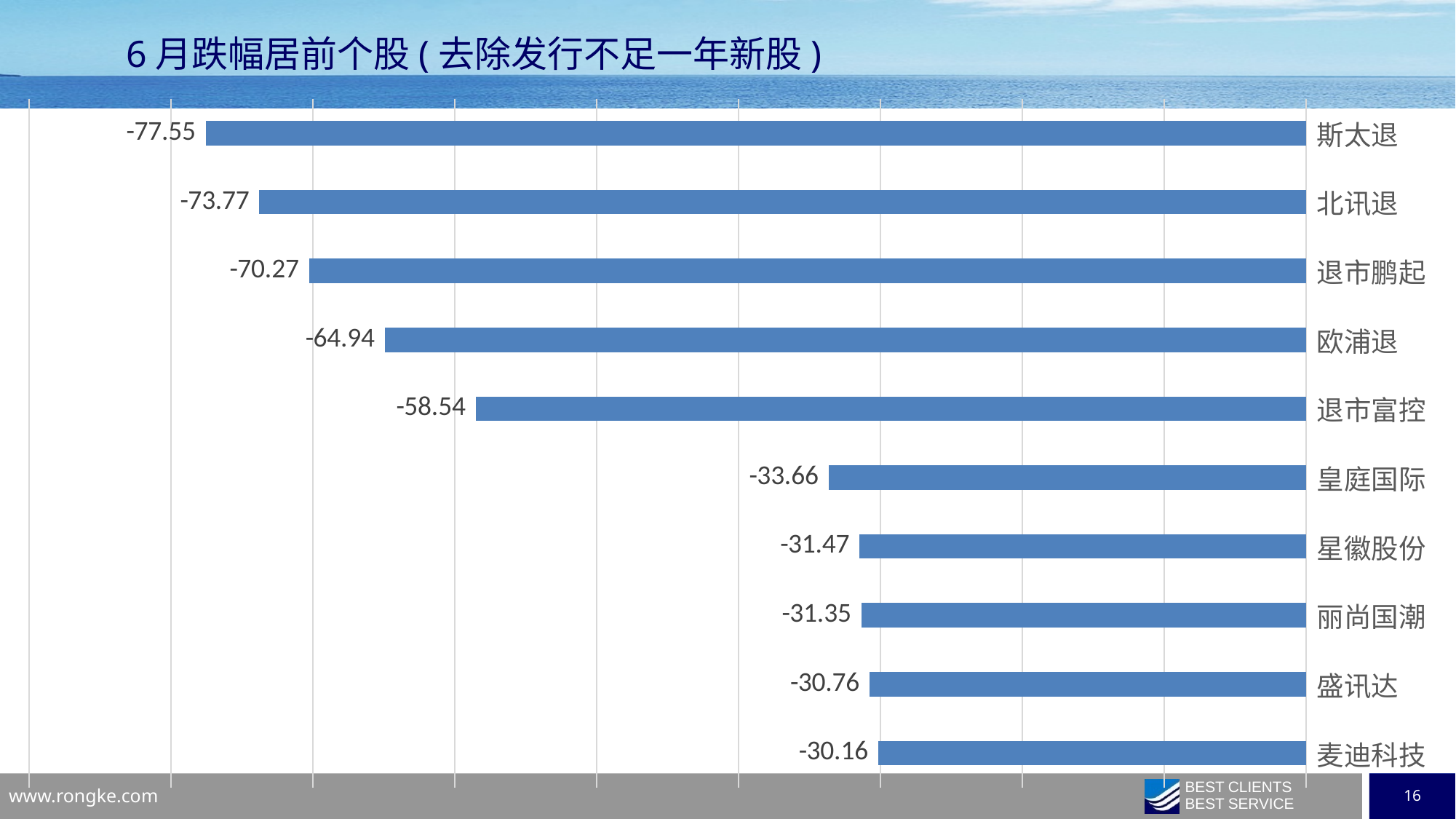
Which stock has the highest (least negative) value on the chart? 麦迪科技 What is the value shown for 斯太退? -77.55 What is the difference between the values for 斯太退 and 北讯退? 3.78 What is the title of the slide? 6月跌幅居前个股（去除发行不足一年新股） Which stock has the lowest (most negative) value on the chart? 斯太退 What is the value shown for 麦迪科技? -30.16 Which has the larger decline, 退市鹏起 or 欧浦退? 退市鹏起 How many stocks are shown on the chart? 10 What kind of chart is shown on the slide? Bar chart What is the value shown for 皇庭国际? -33.66 What is the difference between the values for 退市富控 and 皇庭国际? 24.88 What is the value shown for 欧浦退? -64.94